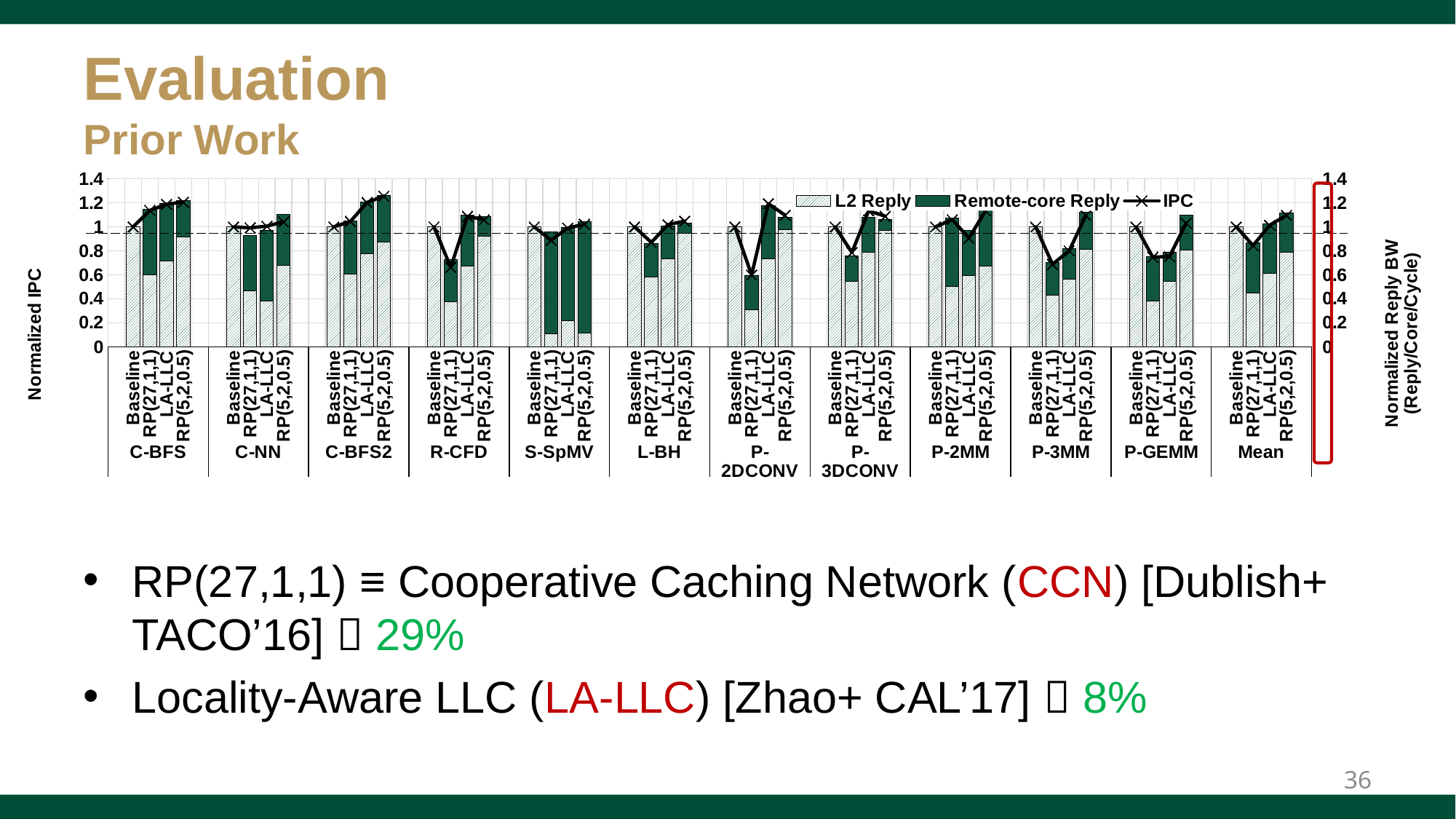
How many benchmark groups (including Mean) are shown along the x axis? 12 Which has the higher IPC: RP(27,1,1) in the C-BFS group or RP(27,1,1) in the R-CFD group? RP(27,1,1) in C-BFS Is the IPC value for RP(27,1,1) in the R-CFD group greater or less than 0.8? less What kind of chart is shown on the slide? Stacked bar chart with a line (IPC) overlay Is the IPC value for RP(5,2,0.5) in the C-BFS2 group greater or less than 1? greater How many configurations are plotted within each benchmark group? 4 What is the title of the right-hand vertical axis? Normalized Reply BW (Reply/Core/Cycle) Is the IPC value for RP(27,1,1) in the P-2DCONV group greater or less than 0.8? less What are the three entries in the chart legend? L2 Reply, Remote-core Reply, IPC How many series does the chart legend list? 3